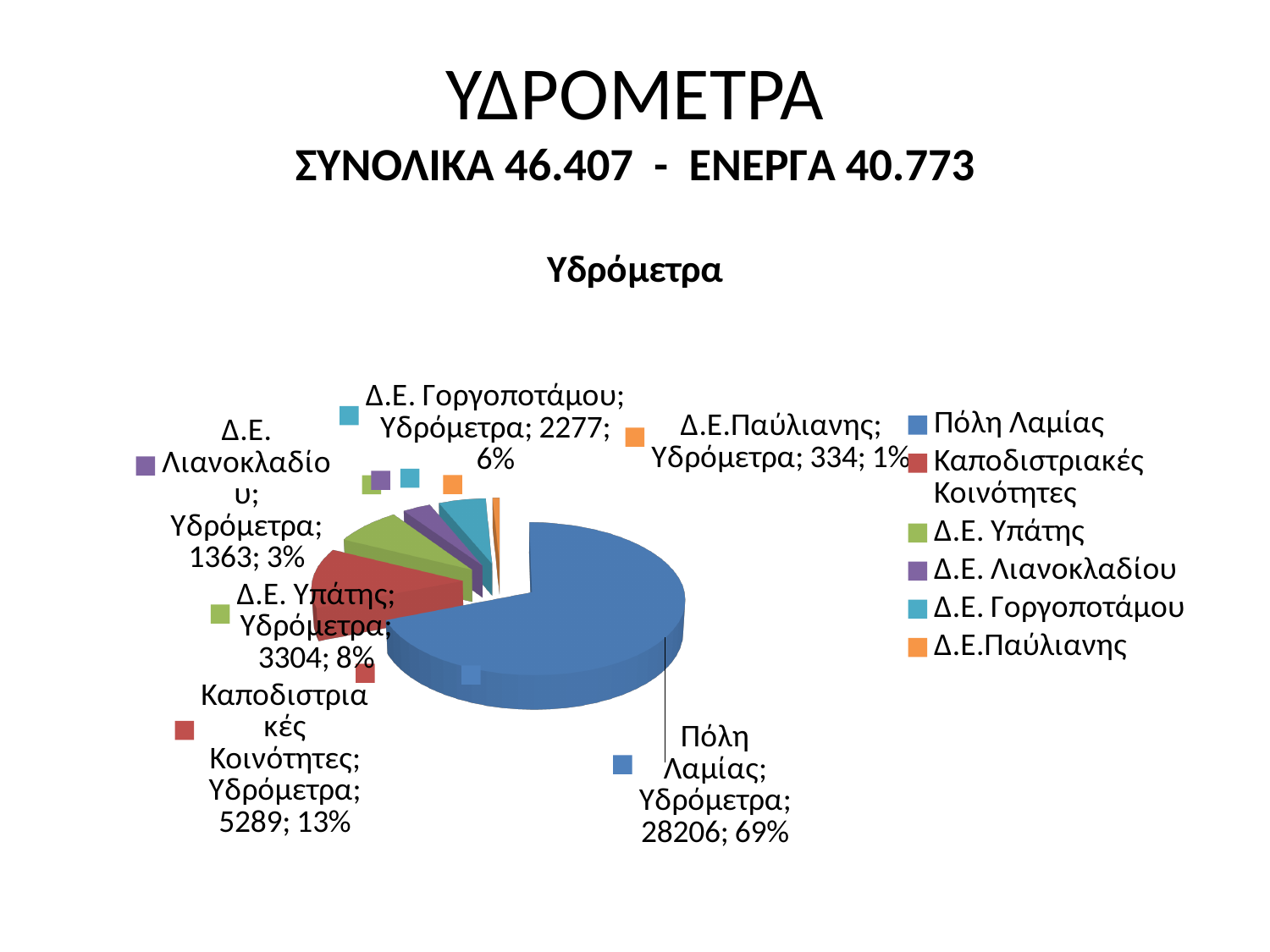
Which category has the largest slice? Πόλη Λαμίας What type of chart is shown on the slide? pie chart Which category has the smallest slice? Δ.Ε.Παύλιανης What share of the pie does Δ.Ε. Υπάτης represent? 8% What is the difference between the values for Δ.Ε. Υπάτης and Δ.Ε. Λιανοκλαδίου? 1941 What is the value for Πόλη Λαμίας? 28206 What is the title of the chart? Υδρόμετρα What is the value for Δ.Ε. Γοργοποτάμου? 2277 How many entries does the legend list? 6 What share of the pie does Δ.Ε.Παύλιανης represent? 1% What is the value for Καποδιστριακές Κοινότητες? 5289 How many slices does the pie chart have? 6